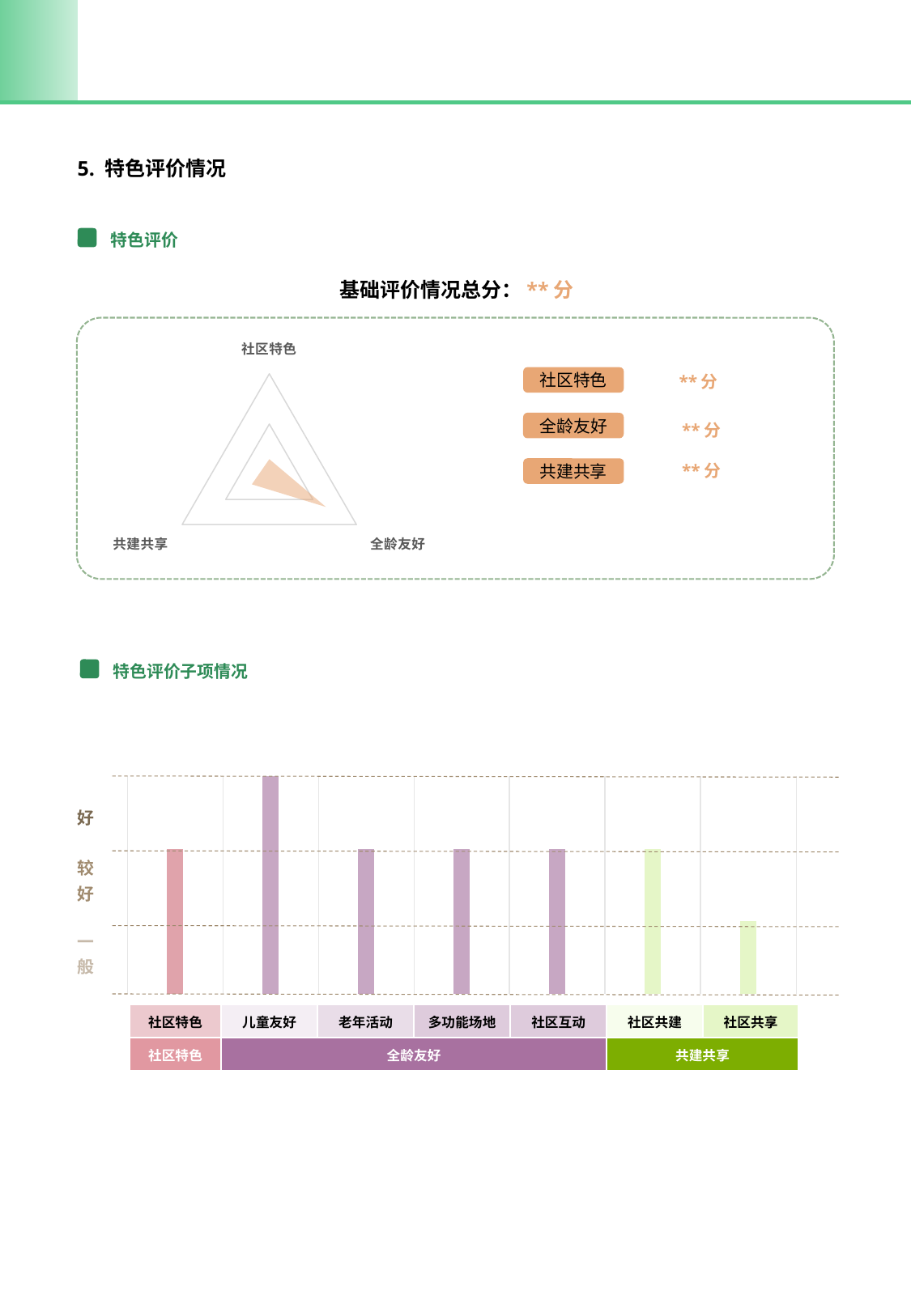
In the 特色评价子项情况 bar chart, which rating level does the bar for 儿童友好 reach? 好 How many axes does the radar chart in the 特色评价 section have? 3 In the 特色评价子项情况 bar chart, which is higher: 社区共建 or 社区共享? 社区共建 In the 特色评价子项情况 bar chart, how many categories are plotted? 7 In the 特色评价子项情况 bar chart, which rating level does the bar for 社区互动 reach? 较好 What kind of chart is shown in the 特色评价 section with the axes 社区特色, 全龄友好 and 共建共享? radar chart In the 特色评价子项情况 bar chart, which category has the highest bar? 儿童友好 What kind of chart is shown under 特色评价子项情况? bar chart In the 特色评价子项情况 bar chart, which category has the lowest bar? 社区共享 In the 特色评价子项情况 bar chart, which is higher: 儿童友好 or 社区共享? 儿童友好 In the 特色评价子项情况 bar chart, how many sub-categories belong to the 全龄友好 group? 4 In the 特色评价子项情况 bar chart, which rating level does the bar for 社区共享 reach? 一般